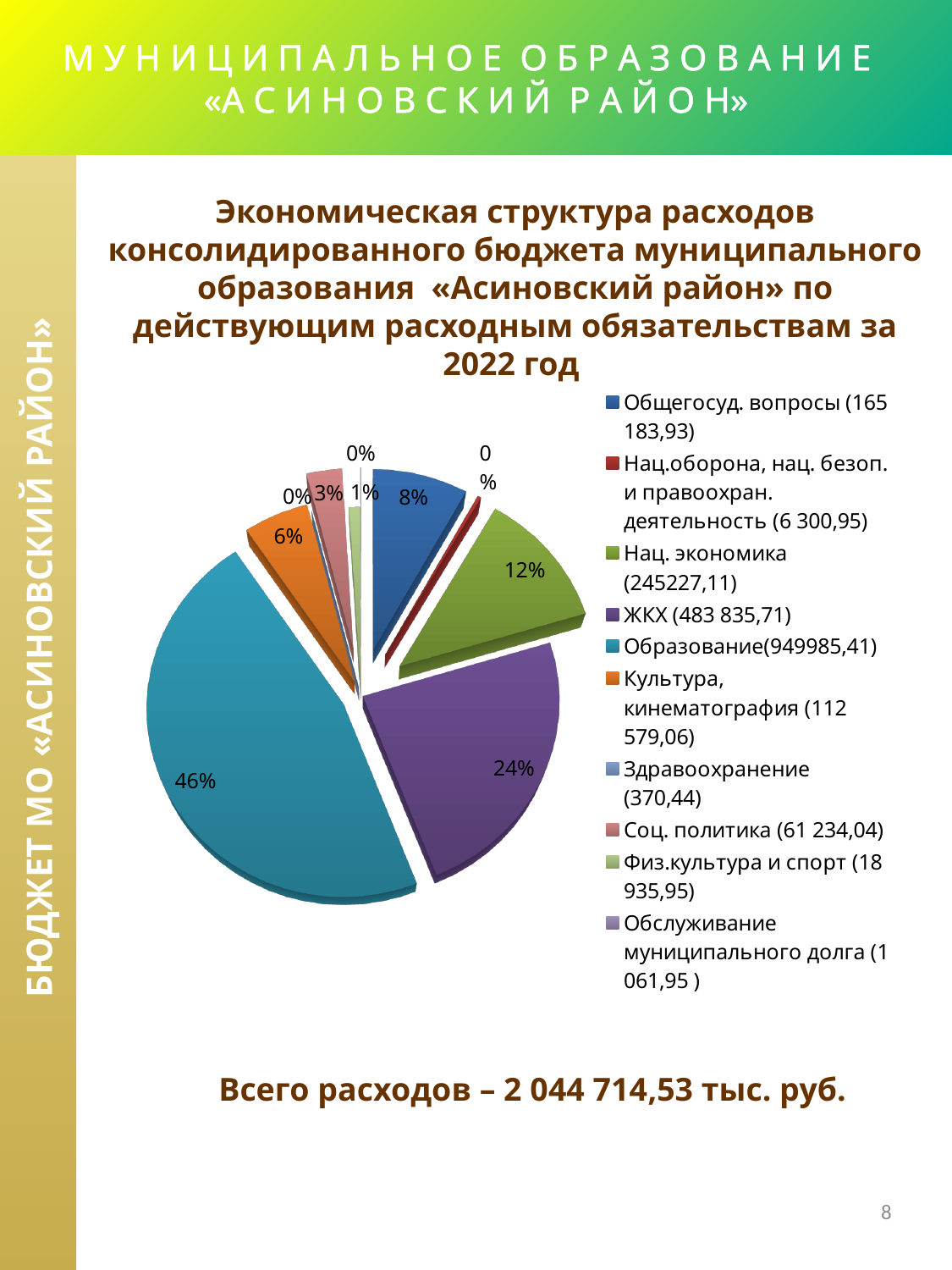
What value is shown in the legend next to Образование? 949985,41 What share of the pie does Общегосуд. вопросы account for? 8% What share of the pie does Соц. политика account for? 3% Which category has the largest slice of the pie? Образование What is the difference in percentage points between the Образование slice and the ЖКХ slice? 22% What share of the pie does ЖКХ account for? 24% How many categories does the legend list? 10 Which is larger: the share for ЖКХ or the share for Нац. экономика? ЖКХ What kind of chart is shown on the slide? pie chart